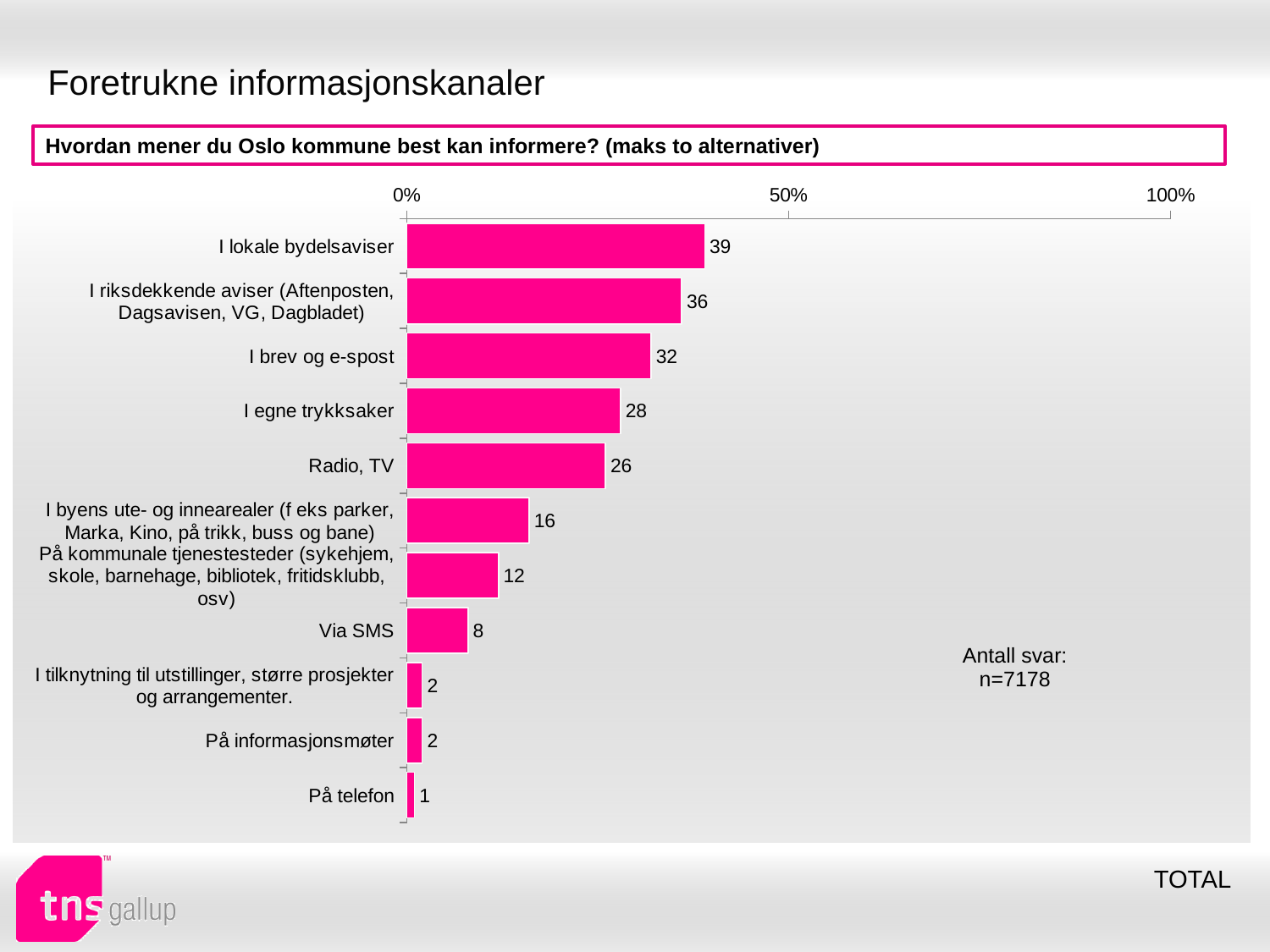
Which category has the lowest value? På telefon What is the difference between the values for "I lokale bydelsaviser" and "I brev og e-spost"? 7 Is the value for "I riksdekkende aviser (Aftenposten, Dagsavisen, VG, Dagbladet)" greater or less than 50%? less How many categories are shown in the chart? 11 Which category has the highest value? I lokale bydelsaviser What is the number of responses (Antall svar) shown on the slide? n=7178 What is the value for "Radio, TV"? 26 What is the value for "På kommunale tjenestesteder (sykehjem, skole, barnehage, bibliotek, fritidsklubb, osv)"? 12 What is the value for "I lokale bydelsaviser"? 39 Which is larger, the value for "I egne trykksaker" or the value for "Radio, TV"? I egne trykksaker What kind of chart is shown on the slide? bar chart What is the value for "Via SMS"? 8